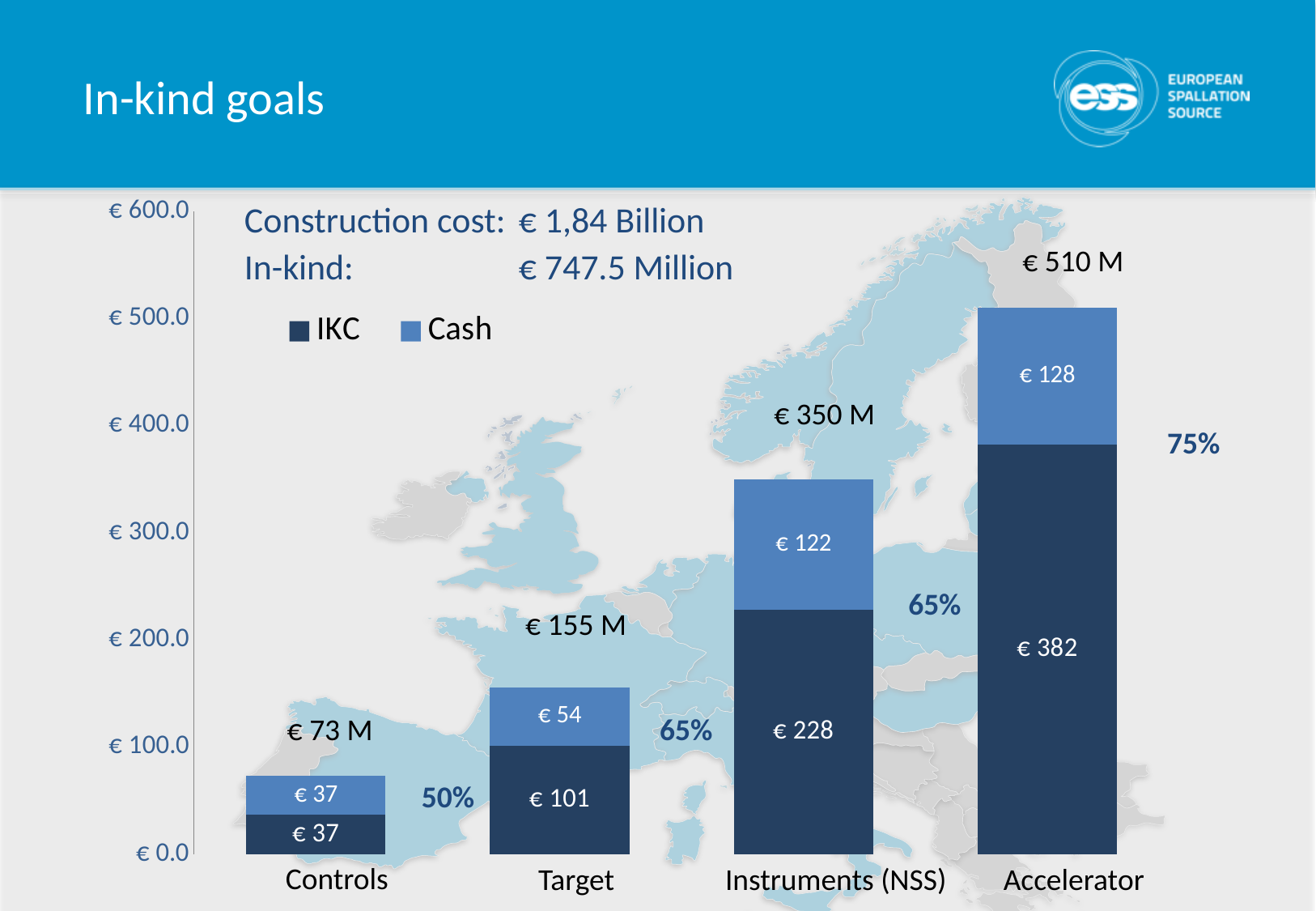
What is the difference between the IKC values for Accelerator and Instruments (NSS)? € 154 What is the total labelled above the Instruments (NSS) bar? € 350 M What is the Cash value for Target? € 54 Is the total for Target greater or less than € 200.0? less What kind of chart is shown on the slide? stacked bar chart How many series does the legend list? 2 What is the IKC value for Accelerator? € 382 How many categories are shown on the x axis? 4 Which category has the lowest total bar? Controls Which category has the highest total bar? Accelerator What percentage is shown next to the Accelerator bar? 75% Which is larger, the Cash value for Instruments (NSS) or the Cash value for Accelerator? Accelerator